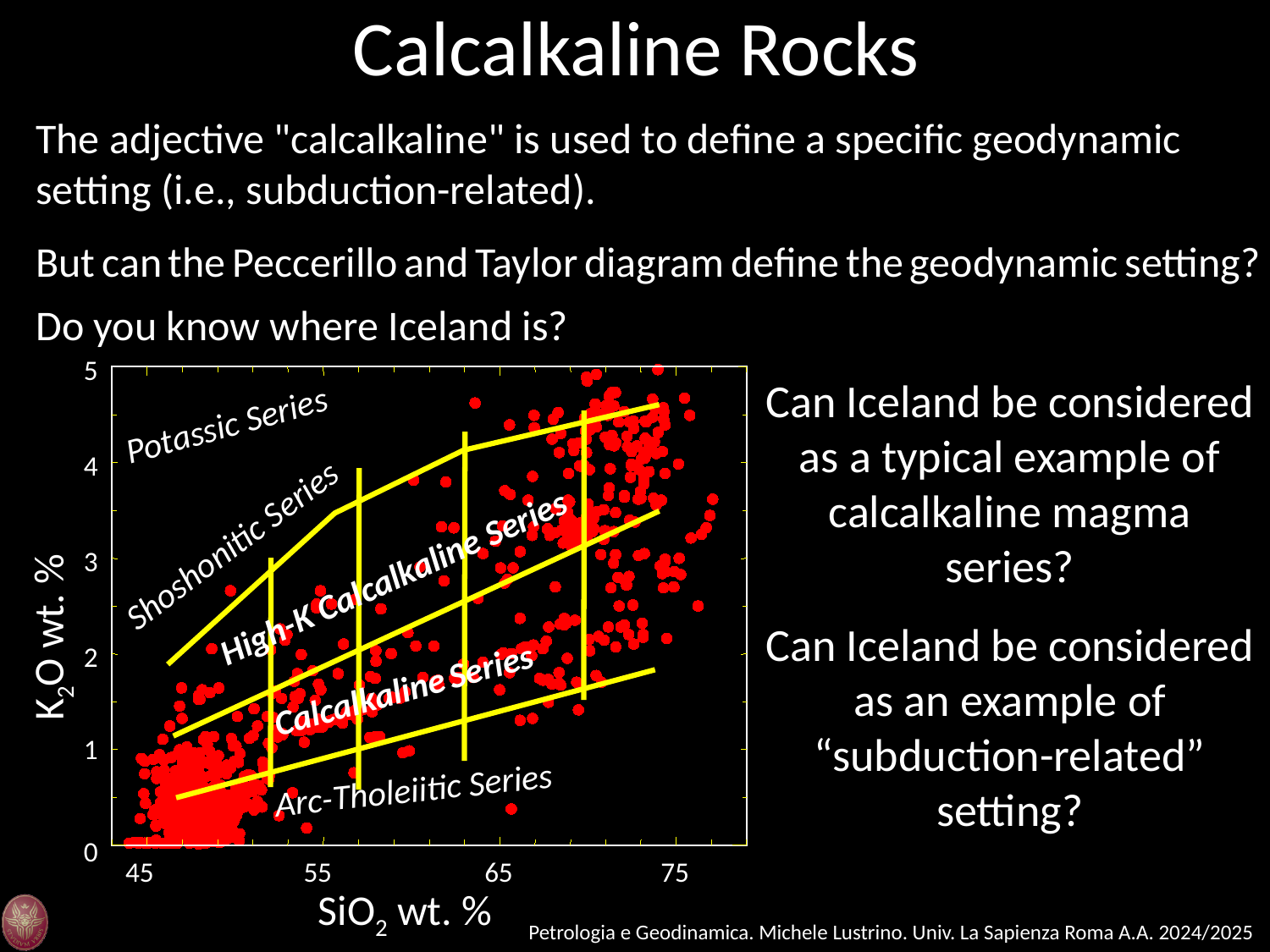
Is the SiO2 value of the densest cluster of red points greater or less than 55? less What kind of chart is shown on the slide? scatter plot What is the label of the y axis of the chart? K2O wt. % What is the label of the x axis of the chart? SiO2 wt. % Is the K2O value of the densest cluster of red points greater or less than 2? less Do the plotted K2O values generally rise or fall as SiO2 increases along the x axis? rise How many named magma series fields are labelled on the chart? 5